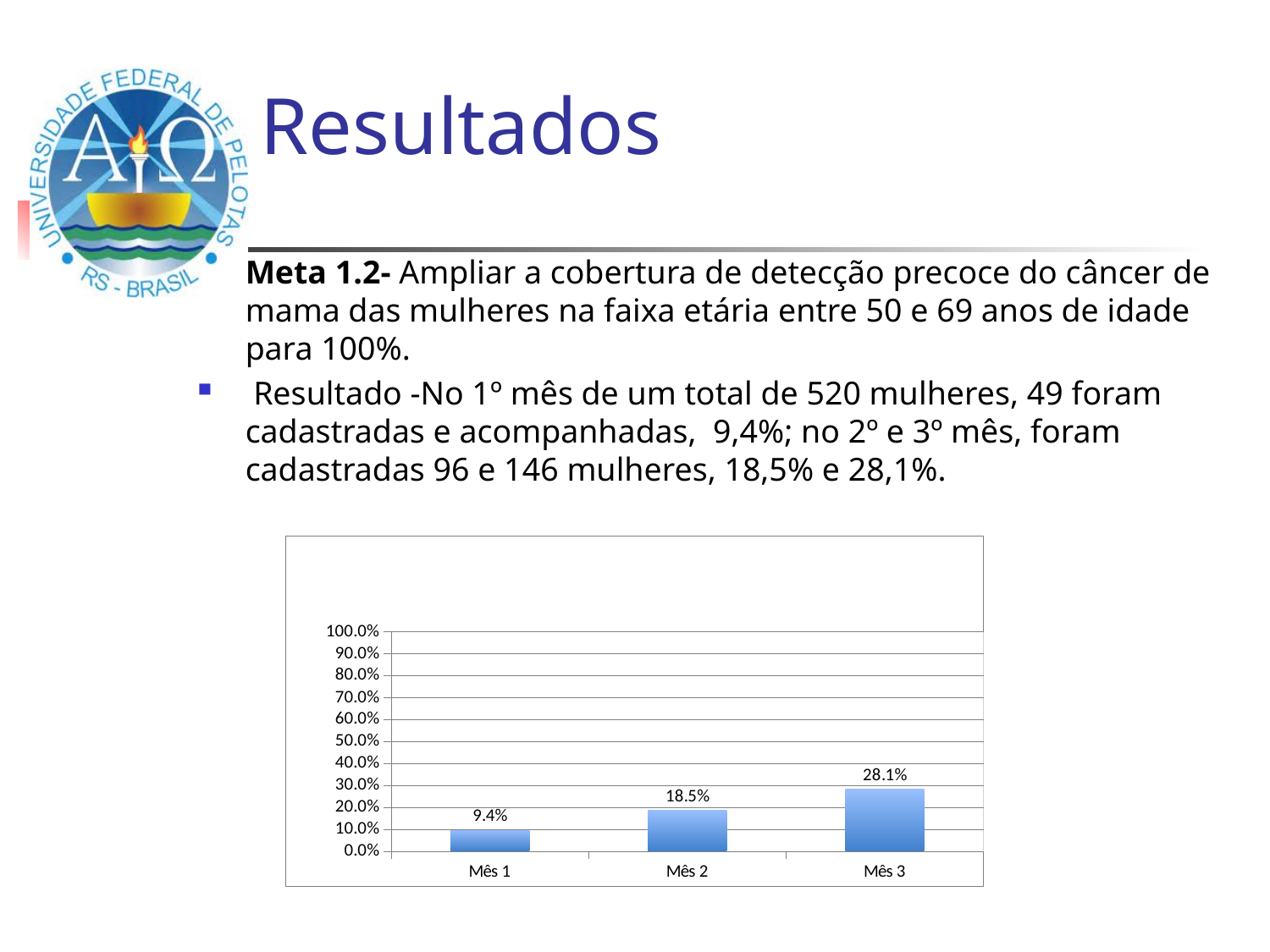
What is the difference between the values for Mês 3 and Mês 1? 18.7% What is the value for Mês 3? 28.1% What kind of chart is shown on the slide? bar chart Is the value for Mês 3 greater or less than 50.0%? less What is the value for Mês 2? 18.5% Which category has the highest value? Mês 3 How many categories are shown on the x axis? 3 Do the values rise or fall from Mês 1 to Mês 3? rise Which is larger, the value for Mês 2 or the value for Mês 3? Mês 3 Which category has the lowest value? Mês 1 What is the difference between the values for Mês 2 and Mês 1? 9.1% What is the value for Mês 1? 9.4%